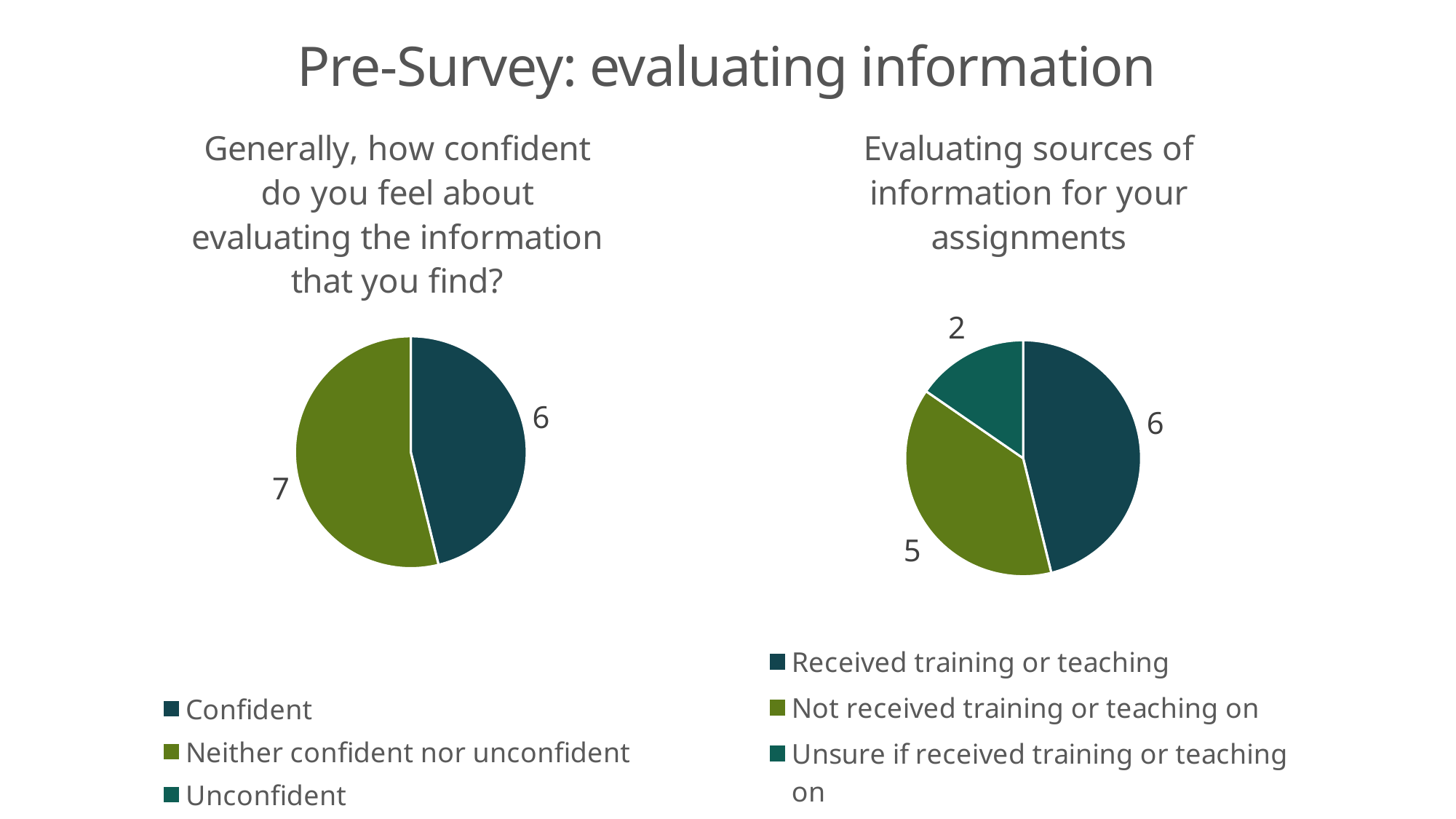
In the right pie chart, which is larger: Received training or teaching, or Not received training or teaching on? Received training or teaching What type of chart is used on the left side of the slide? Pie chart In the right pie chart ("Evaluating sources of information for your assignments"), what is the value for Received training or teaching? 6 How many entries does the legend of the left chart list? 3 In the left pie chart, what is the value for Neither confident nor unconfident? 7 In the left pie chart, which category has the largest slice? Neither confident nor unconfident In the left pie chart ("Generally, how confident do you feel about evaluating the information that you find?"), how many respondents answered Confident? 6 In the right pie chart, what is the value for Unsure if received training or teaching on? 2 In the left pie chart, what is the difference between the Neither confident nor unconfident value and the Confident value? 1 In the right pie chart, what is the value for Not received training or teaching on? 5 In the right pie chart, what is the total of all slices? 13 In the right pie chart, which category has the smallest slice? Unsure if received training or teaching on